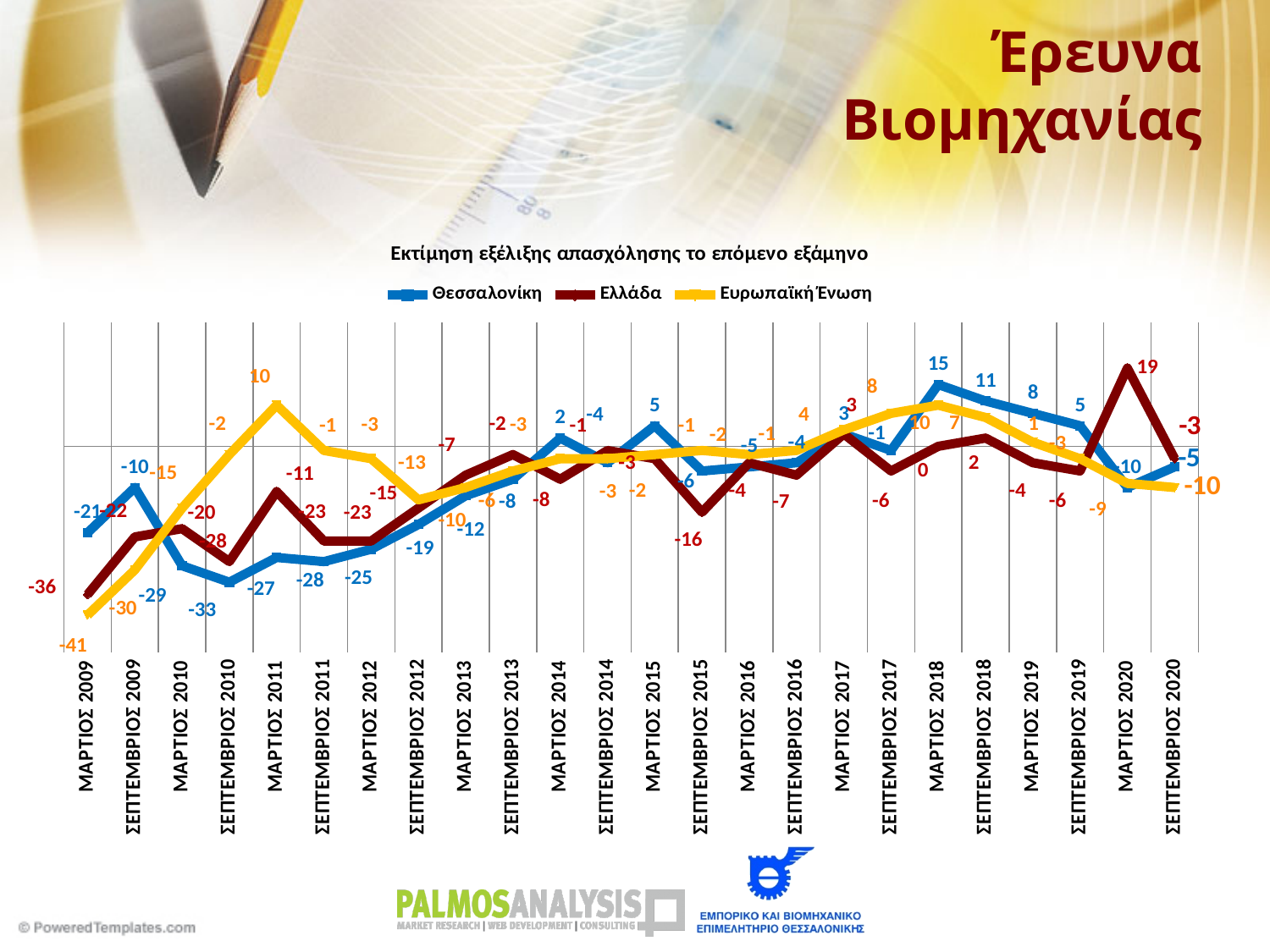
What is the value for Θεσσαλονίκη in ΣΕΠΤΕΜΒΡΙΟΣ 2010? -33 How many series does the legend list? 3 How many time points are plotted along the x axis? 24 In ΜΑΡΤΙΟΣ 2020, which series has the higher value, Θεσσαλονίκη or Ελλάδα? Ελλάδα In which period does the Ελλάδα series reach its highest value? ΜΑΡΤΙΟΣ 2020 What is the value for Θεσσαλονίκη in ΜΑΡΤΙΟΣ 2018? 15 What is the value for Ελλάδα in ΜΑΡΤΙΟΣ 2020? 19 What is the value for Ευρωπαϊκή Ένωση in ΜΑΡΤΙΟΣ 2009? -41 What kind of chart is shown on the slide? line chart What is the title of the chart? Εκτίμηση εξέλιξης απασχόλησης το επόμενο εξάμηνο In which period does the Θεσσαλονίκη series reach its lowest value? ΣΕΠΤΕΜΒΡΙΟΣ 2010 What is the difference between the Θεσσαλονίκη and Ελλάδα values in ΜΑΡΤΙΟΣ 2018? 15